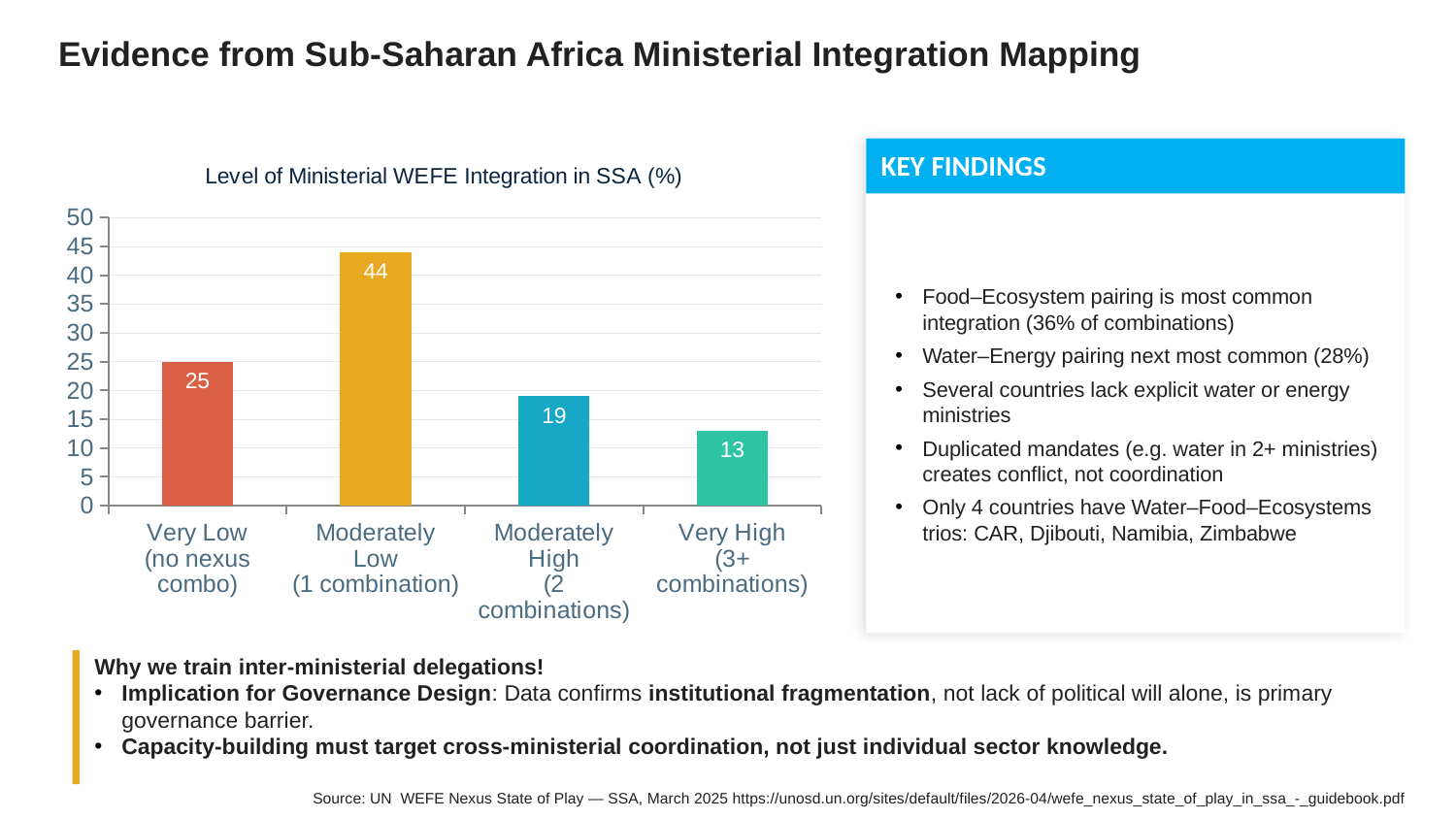
What is the title of the chart? Level of Ministerial WEFE Integration in SSA (%) What is the value for Very Low (no nexus combo)? 25 What is the value for Very High (3+ combinations)? 13 What kind of chart is shown? bar chart Is the value for Moderately High greater or less than 20? less Which is larger, the value for Very Low or the value for Moderately High? Very Low What colour is the bar for Moderately Low (1 combination)? yellow What is the difference between the values for Moderately Low and Moderately High? 25 Which category has the highest value? Moderately Low (1 combination) What is the value for Moderately Low (1 combination)? 44 How many categories are shown on the x axis? 4 Which category has the lowest value? Very High (3+ combinations)